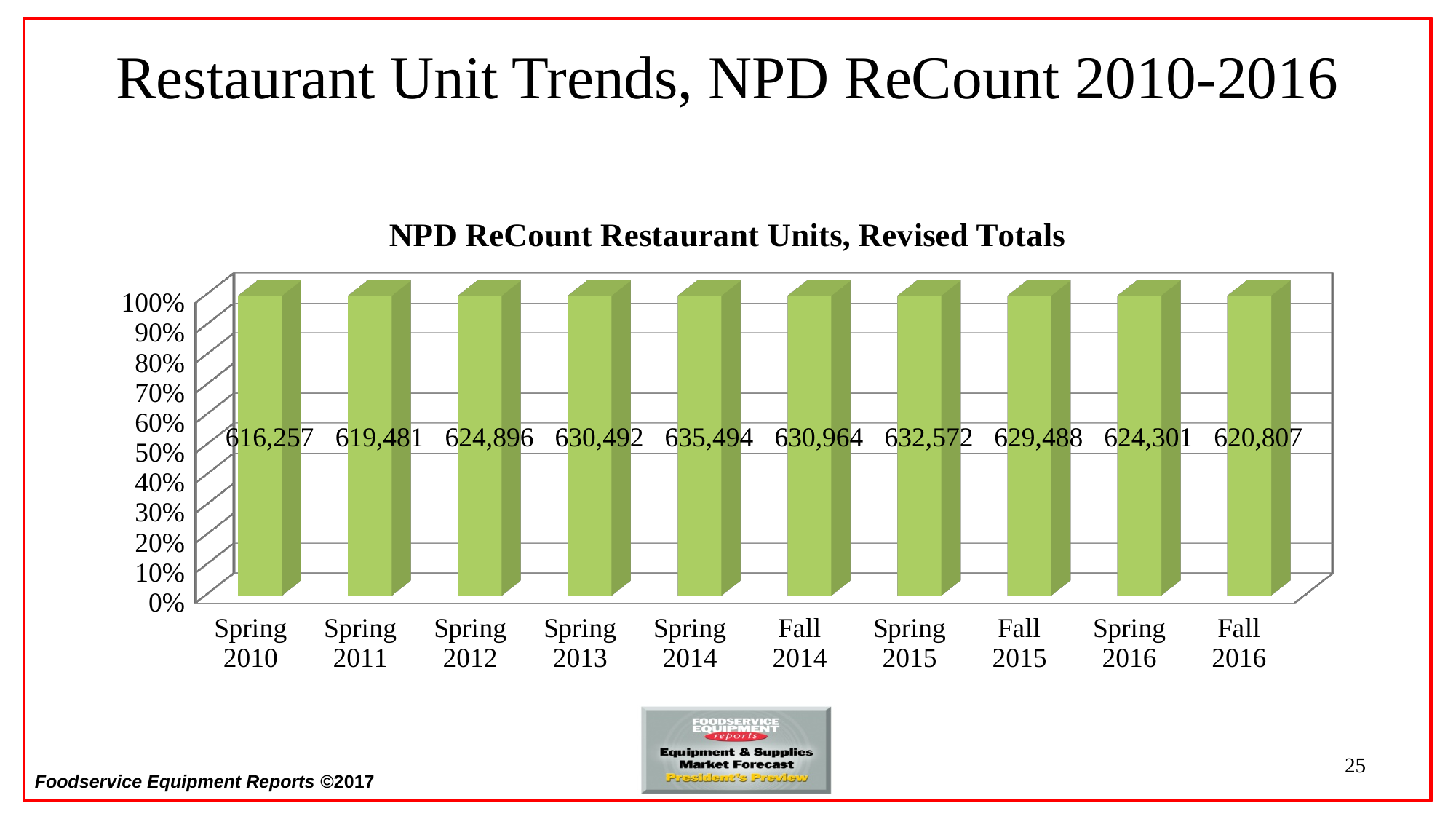
What is the title of the chart? NPD ReCount Restaurant Units, Revised Totals Do the labelled values rise or fall from Spring 2010 to Spring 2014? Rise What is the data label value for Fall 2015? 629,488 What kind of chart is this? Bar chart Which period has the highest labelled restaurant unit count? Spring 2014 Which period has the lowest labelled restaurant unit count? Spring 2010 What is the data label value for Fall 2016? 620,807 What is the data label value for Spring 2010? 616,257 What is the difference between the labelled values for Spring 2015 and Fall 2015? 3,084 What is the difference between the labelled values for Spring 2014 and Spring 2010? 19,237 Which labelled value is larger, Spring 2013 or Fall 2014? Fall 2014 How many periods are shown on the x axis? 10